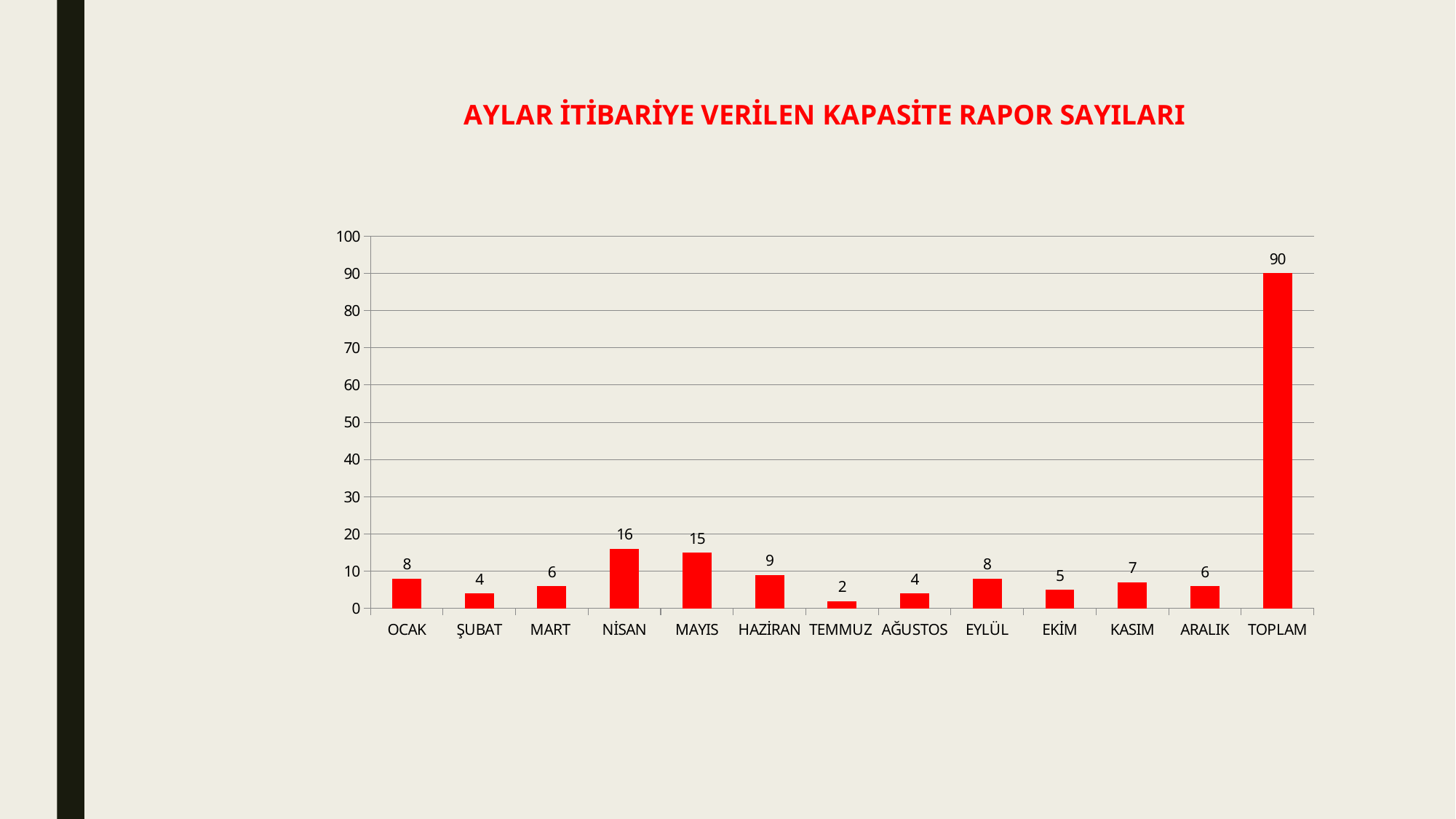
How many categories are shown on the x axis? 13 What is the difference between the values for NİSAN and MAYIS? 1 Which is larger, the value for HAZİRAN or the value for EKİM? HAZİRAN What is the value for TEMMUZ? 2 Which month (excluding TOPLAM) has the highest value? NİSAN What is the value for NİSAN? 16 What is the difference between the values for TOPLAM and NİSAN? 74 What kind of chart is shown on the slide? bar chart Which category has the lowest value? TEMMUZ What is the value for TOPLAM? 90 Is the value for TOPLAM greater or less than 80? greater What is the title of the chart? AYLAR İTİBARİYE VERİLEN KAPASİTE RAPOR SAYILARI